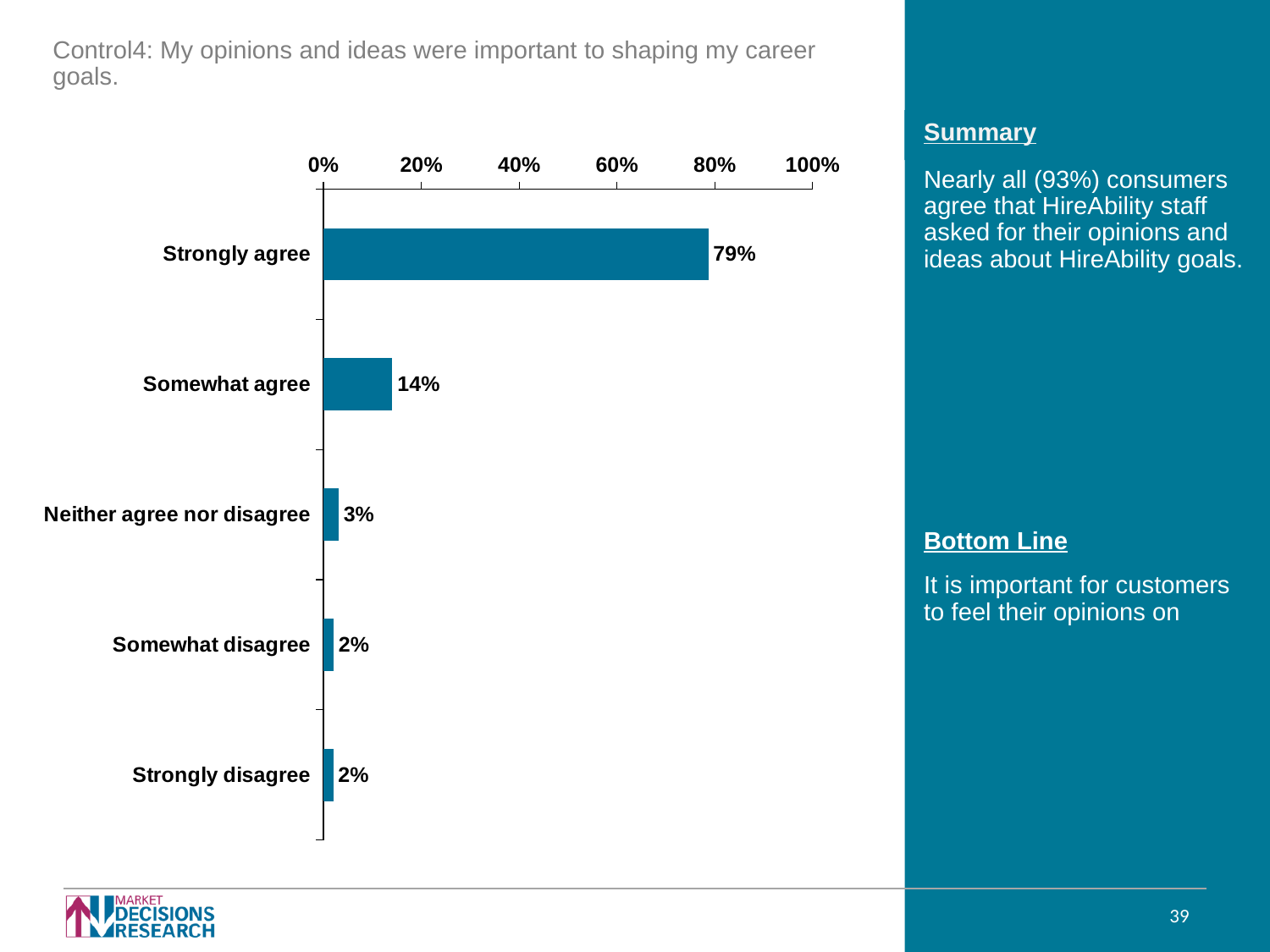
How many categories are shown in the chart? 5 Which is larger, 'Somewhat agree' or 'Neither agree nor disagree'? Somewhat agree What is the value shown for 'Strongly disagree'? 2% Which category has the highest value? Strongly agree Is the value for 'Strongly agree' greater or less than 60%? greater What percentage chose 'Neither agree nor disagree'? 3% What percentage of respondents selected 'Strongly agree'? 79% What is the combined value of 'Strongly agree' and 'Somewhat agree'? 93% What is the value for 'Somewhat agree'? 14% What is the difference between 'Strongly agree' and 'Somewhat agree'? 65% What is the maximum value shown on the percentage axis? 100% What kind of chart is shown on the slide? Bar chart